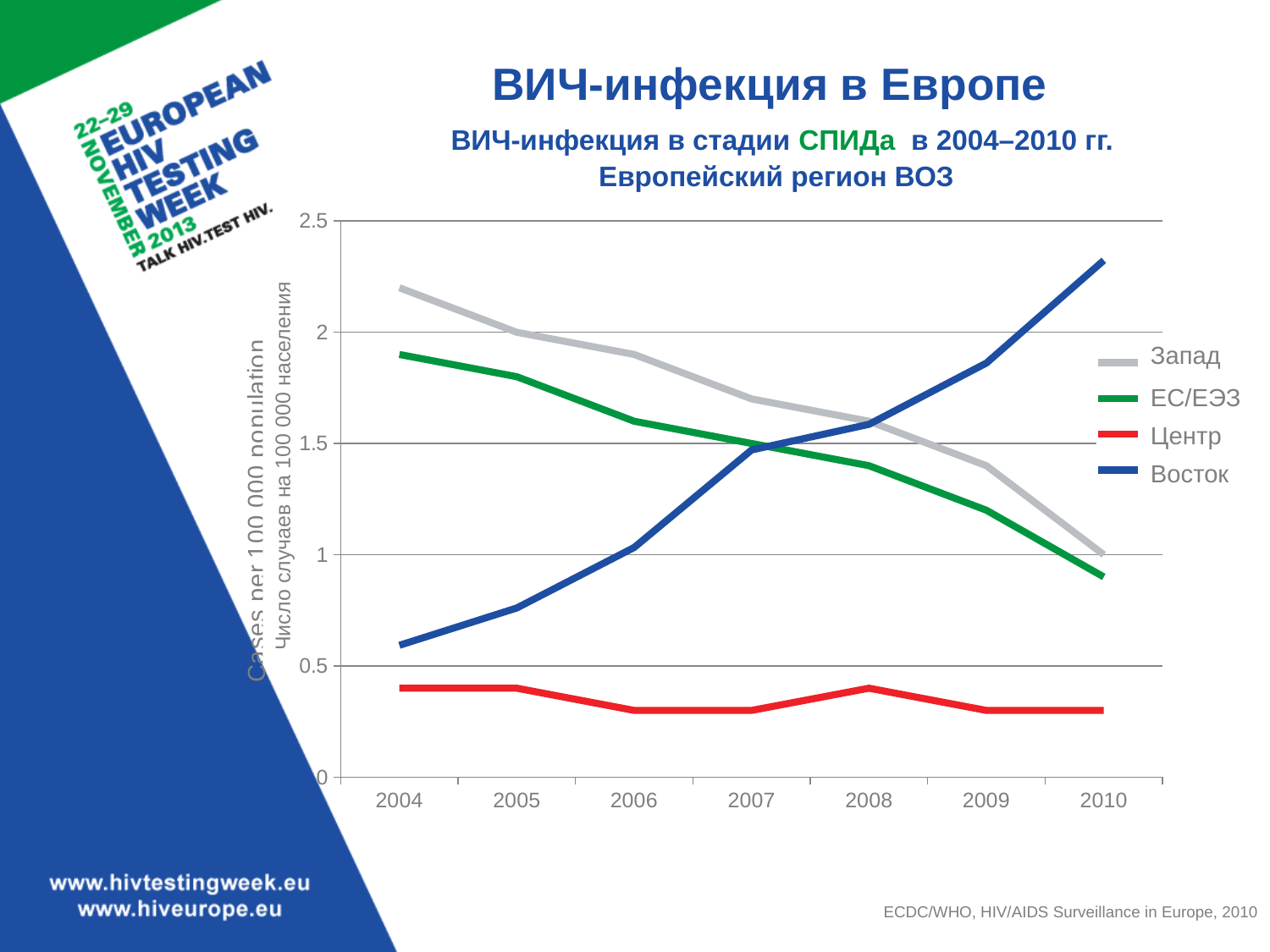
Is the value for Восток in 2010 greater or less than 2? greater Is the value for Запад in 2004 greater or less than 2? greater Does the Восток line rise or fall from 2004 to 2010? rise Is the value for Центр in 2008 greater or less than 0.5? less How many series does the legend list? 4 In 2004, which is larger: the value for Запад or the value for Восток? Запад Which series has the lowest value in 2006? Центр What kind of chart is shown on the slide? line chart Does the Запад line rise or fall from 2004 to 2010? fall Which series has the highest value in 2010? Восток How many years are plotted along the x axis? 7